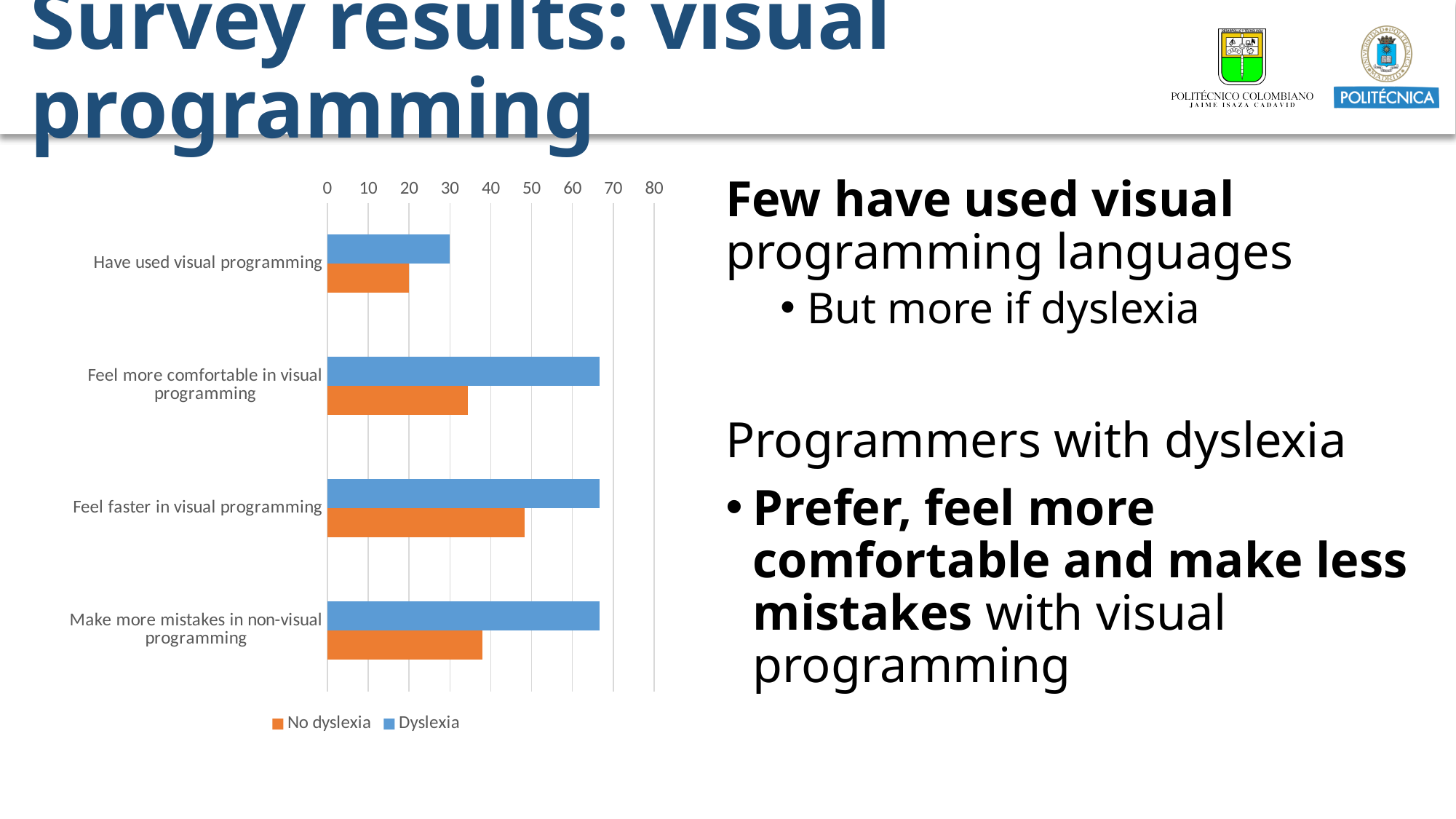
How many categories are shown on the chart? 4 What is the value for 'Have used visual programming' in the Dyslexia series? 30 How many series does the chart's legend list? 2 Is the Dyslexia value for 'Feel faster in visual programming' greater or less than 70? less Is the Dyslexia value for 'Feel more comfortable in visual programming' greater or less than 60? greater What is the value for 'Have used visual programming' in the No dyslexia series? 20 Which colour represents the Dyslexia series in the chart? blue What kind of chart is shown on the slide? bar chart For 'Feel faster in visual programming', which series has the larger value, Dyslexia or No dyslexia? Dyslexia Is the No dyslexia value for 'Make more mistakes in non-visual programming' greater or less than 30? greater Which category has the highest value in the No dyslexia series? Feel faster in visual programming Which category has the lowest value in the Dyslexia series? Have used visual programming